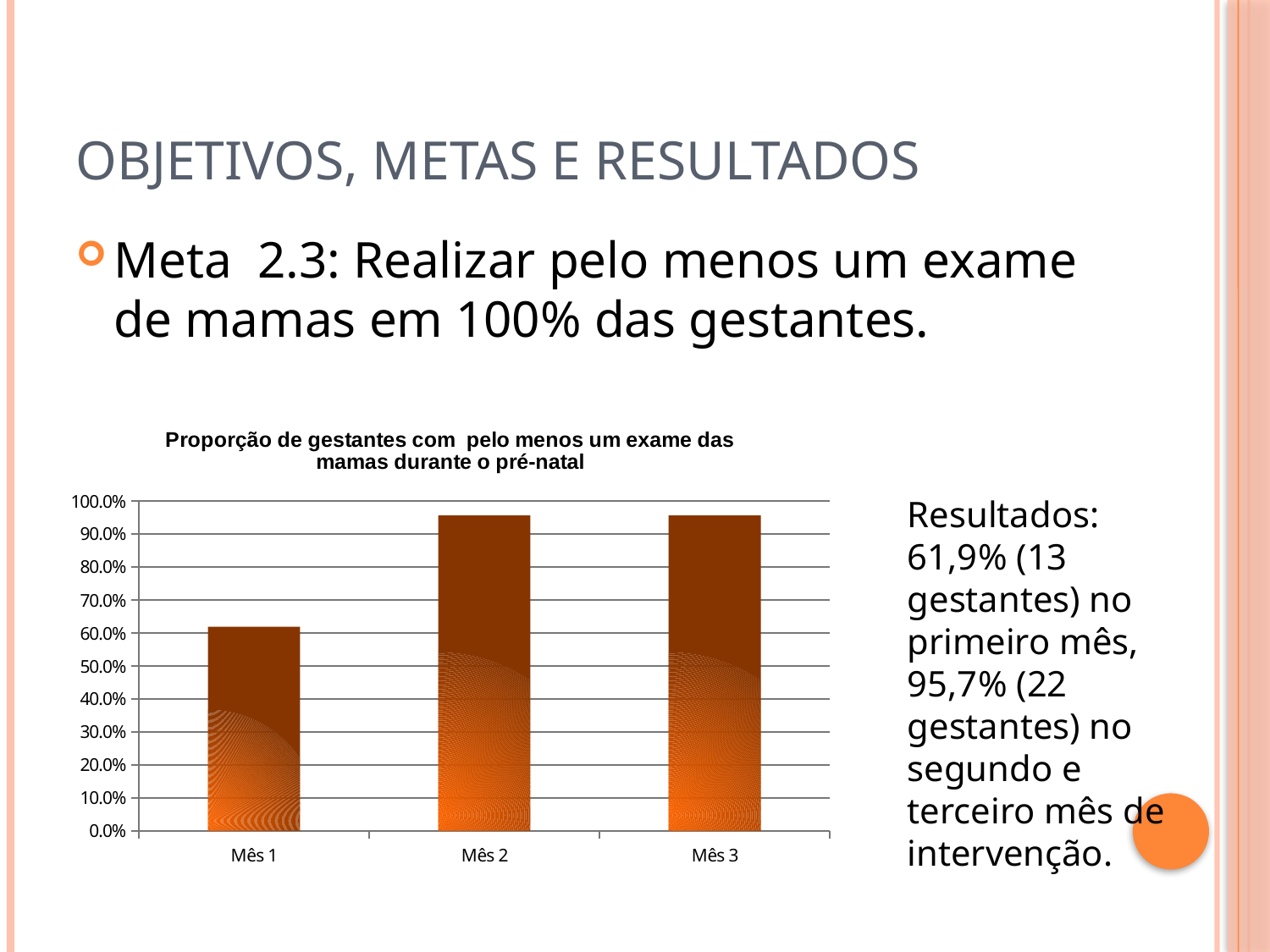
Which month has the lowest proportion of pregnant women with at least one breast exam? Mês 1 Is the value for Mês 1 greater or less than 70.0%? less What is the highest value shown on the vertical axis of the chart? 100.0% Is the value for Mês 2 greater or less than 90.0%? greater Is the value for Mês 1 greater or less than 50.0%? greater How many categories (months) are plotted on the chart? 3 Which is larger, the value for Mês 1 or the value for Mês 2? Mês 2 Do the values rise or fall from Mês 1 to Mês 2? rise What kind of chart is shown on the slide? bar chart What is the title of the chart? Proporção de gestantes com pelo menos um exame das mamas durante o pré-natal